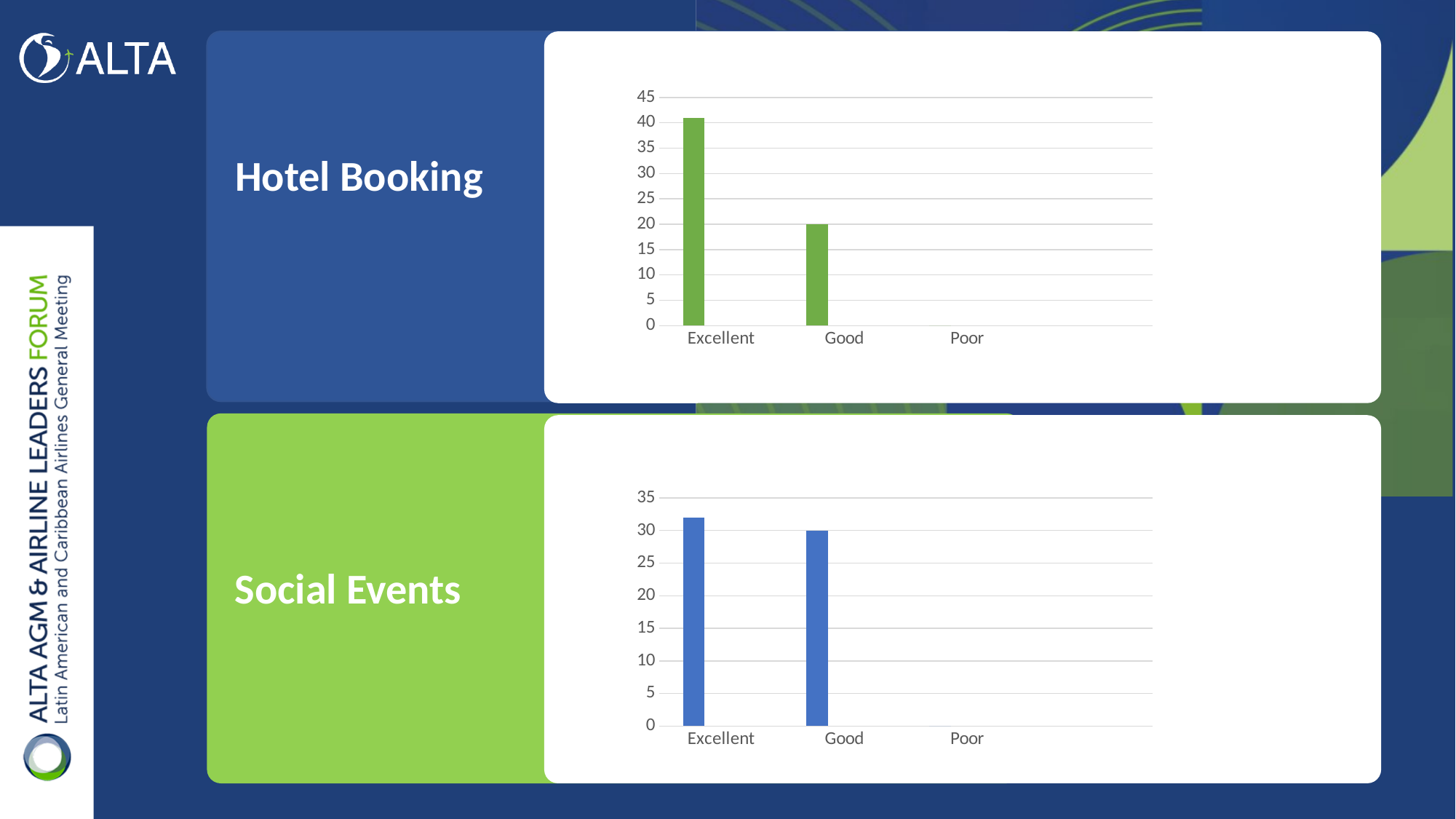
In the Social Events chart, which category has the lowest value? Poor How many categories are shown on the x axis of the Social Events chart? 3 In the Hotel Booking chart, what is the value for Good? 20 What kind of chart is the Hotel Booking chart? bar chart In the Social Events chart, which category has the highest value? Excellent In the Hotel Booking chart, which category has the highest value? Excellent In the Hotel Booking chart, is the value for Excellent greater or less than 35? greater In the Social Events chart, is the value for Excellent greater or less than 30? greater In the Social Events chart, what is the value for Good? 30 In the Hotel Booking chart, which is larger, the value for Excellent or the value for Good? Excellent What is the title of the bottom chart's panel on the slide? Social Events In the Hotel Booking chart, which category has the lowest value? Poor